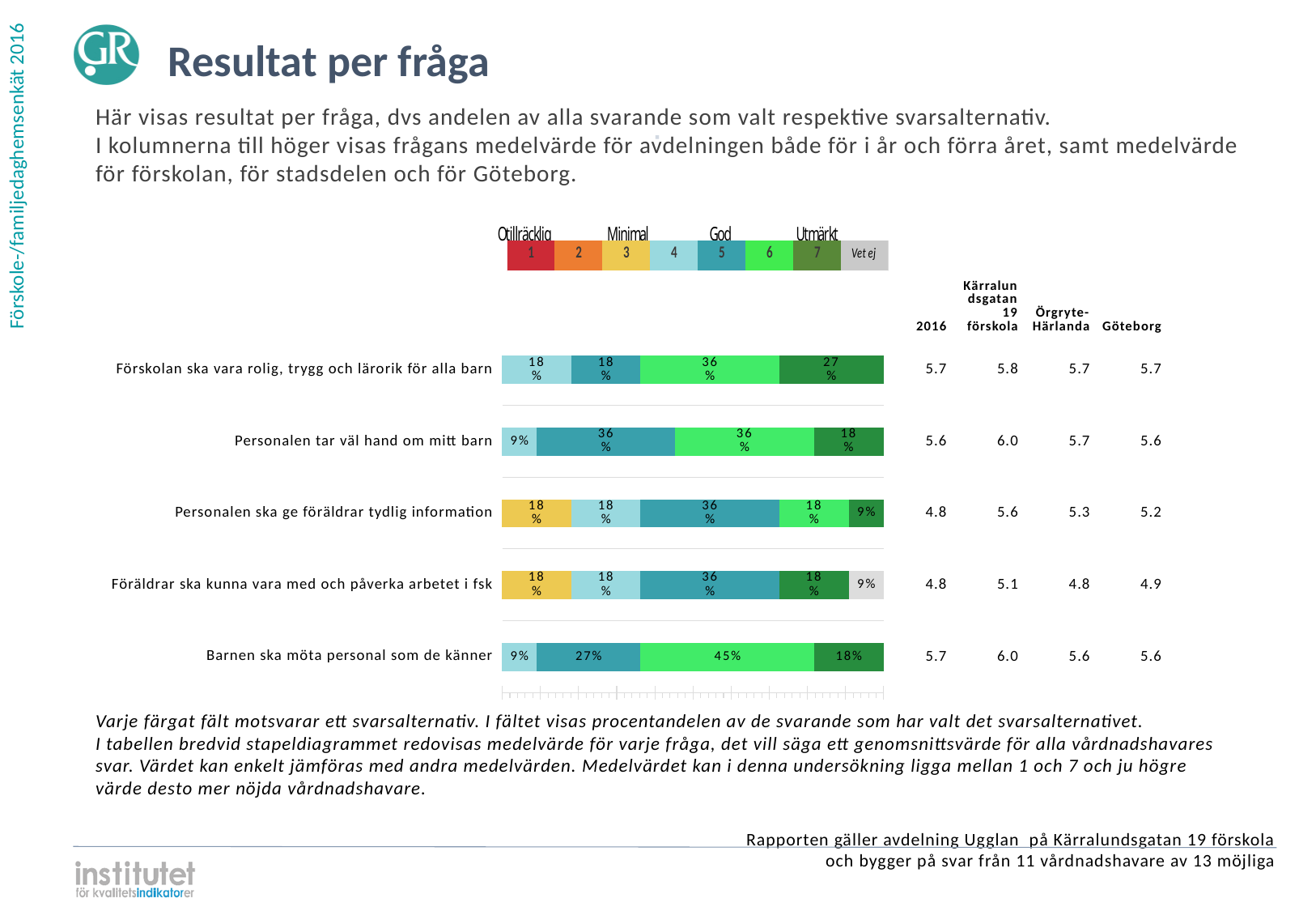
Which answer alternative has the smallest share for 'Personalen tar väl hand om mitt barn'? 4 (9%) What percentage of respondents chose alternative 7 (dark green) for 'Förskolan ska vara rolig, trygg och lärorik för alla barn'? 27% Which answer alternative has the largest share for 'Personalen ska ge föräldrar tydlig information'? 5 (36%) What percentage of respondents chose alternative 6 (bright green) for 'Barnen ska möta personal som de känner'? 45% For 'Barnen ska möta personal som de känner', what is the difference between the share for alternative 6 and the share for alternative 5? 18% For 'Förskolan ska vara rolig, trygg och lärorik för alla barn', which is larger: the share for alternative 6 or the share for alternative 7? Alternative 6 (36%) How many questions (categories) are shown in the bar chart? 5 What kind of chart is used to show the share of respondents choosing each answer alternative? Stacked bar chart What percentage of respondents answered 'Vet ej' for 'Föräldrar ska kunna vara med och påverka arbetet i fsk'? 9% What is the 2016 mean value shown for 'Personalen ska ge föräldrar tydlig information'? 4.8 Which question has the lowest mean value in the Göteborg column? Föräldrar ska kunna vara med och påverka arbetet i fsk (4.9) How many answer alternatives does the colour legend above the chart list? 8